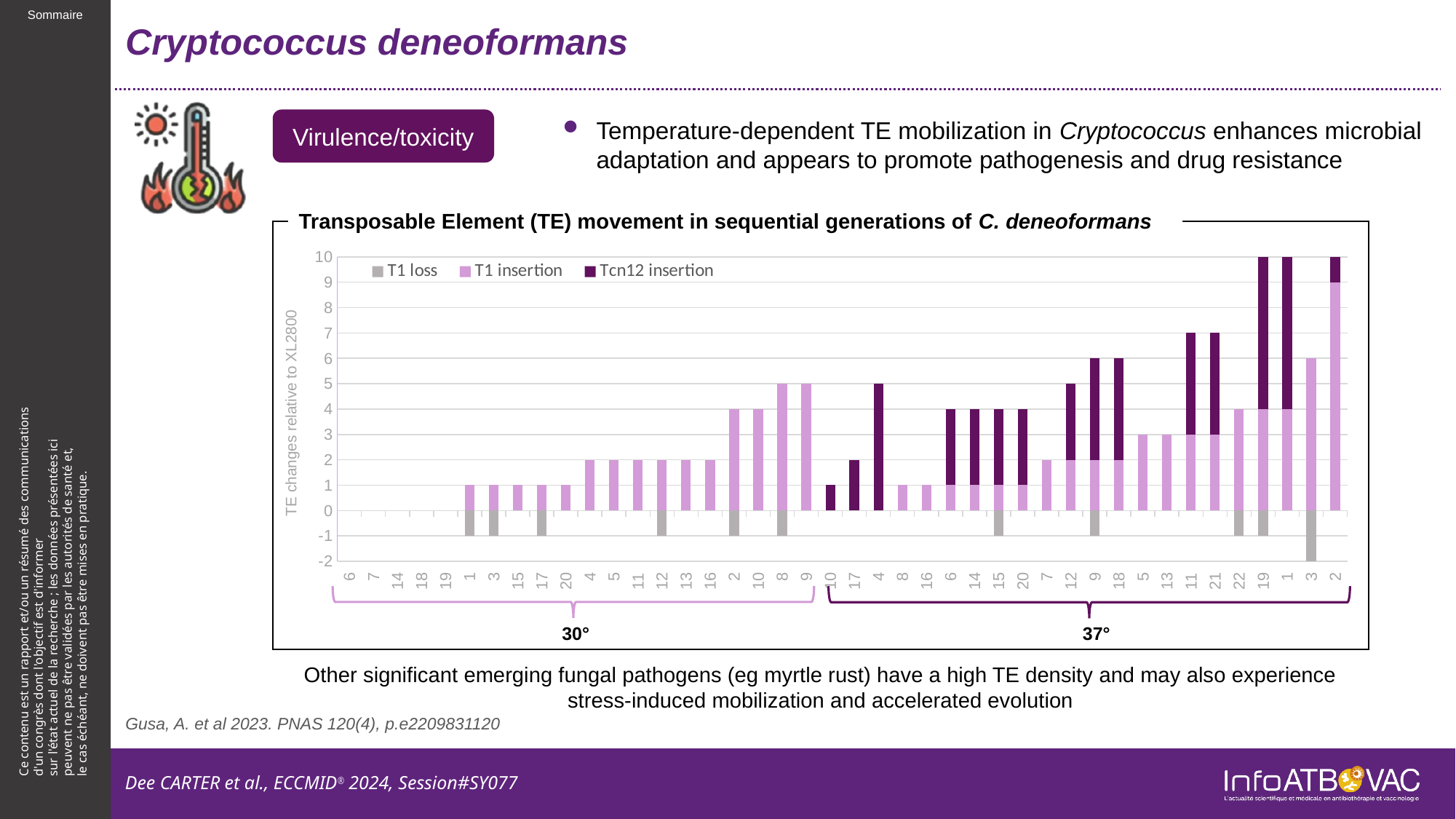
Which has the larger T1 insertion value in the 30° group: isolate 2 or isolate 1? Isolate 2 Which isolate has the lowest (most negative) T1 loss value? Isolate 3 in the 37° group What is the Tcn12 insertion value for isolate 4 in the 37° group? 5 What are the three series named in the chart legend? T1 loss, T1 insertion, Tcn12 insertion What is the label of the y axis of the chart? TE changes relative to XL2800 What kind of chart is shown on the slide? Stacked bar chart How many series does the chart legend list? 3 What is the T1 loss value for isolate 3 in the 37° group? -2 What is the T1 insertion value for isolate 8 in the 30° group? 5 How many isolates (bars) are in the 30° group of the chart? 20 Is the total positive TE change for isolate 11 in the 37° group greater or less than 5? greater How many isolates (bars) are in the 37° group of the chart? 22